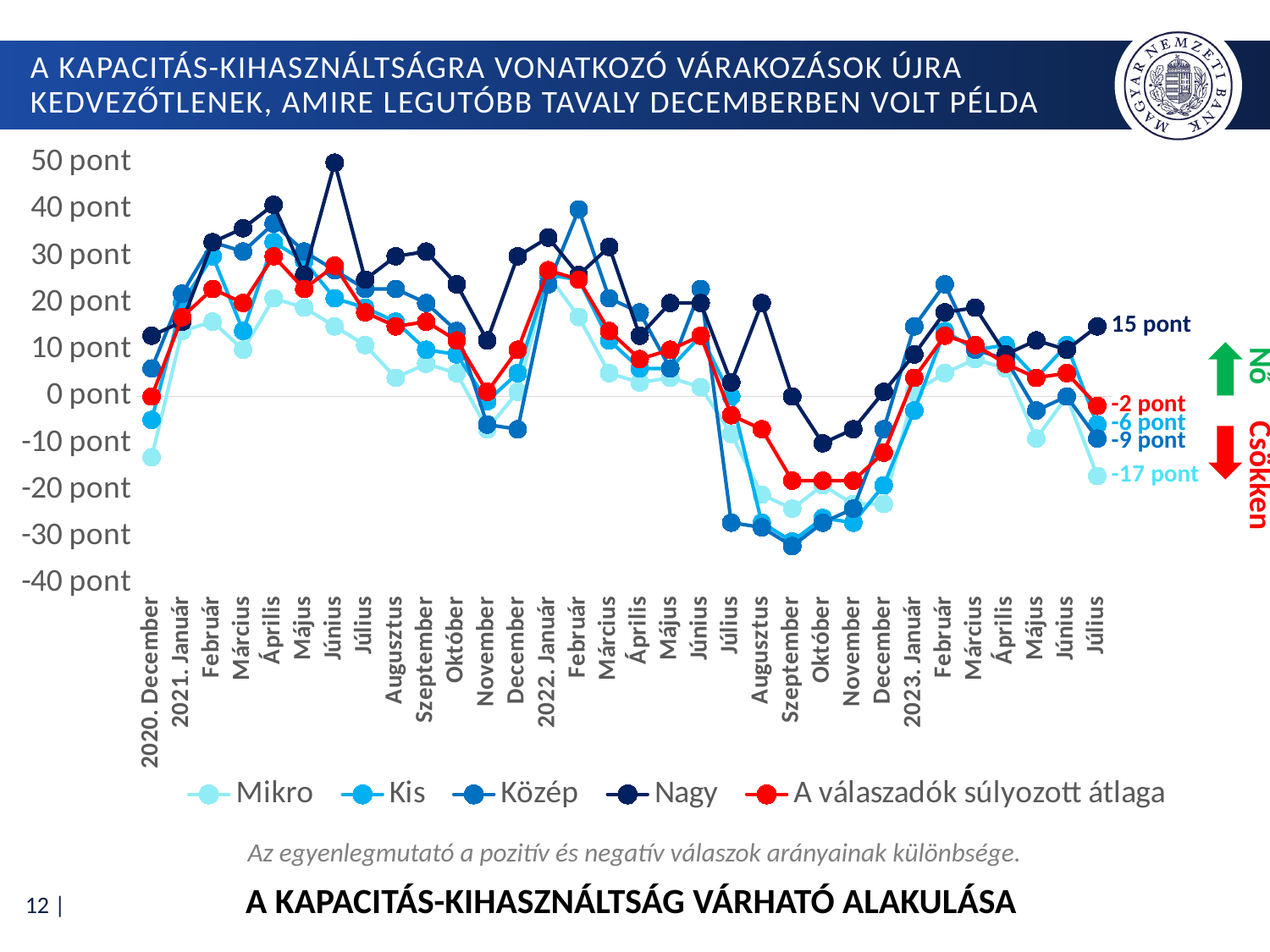
How many series does the legend list? 5 What is the value for the Nagy series in 2023 Július? 15 pont What kind of chart is shown on the slide? line chart What is the value of 'A válaszadók súlyozott átlaga' in 2023 Július? -2 pont What is the value for the Közép series in 2023 Július? -9 pont What is the value for the Mikro series in 2023 Július? -17 pont What is the difference between the Nagy and Mikro values in 2023 Július? 32 pont What is the value for the Kis series in 2023 Július? -6 pont Is the value for the Nagy series in 2021 Június greater or less than 40 pont? greater What is the title of the chart shown at the bottom of the slide? A KAPACITÁS-KIHASZNÁLTSÁG VÁRHATÓ ALAKULÁSA Which series has the highest value in 2023 Július? Nagy Which series has the lowest value in 2023 Július? Mikro